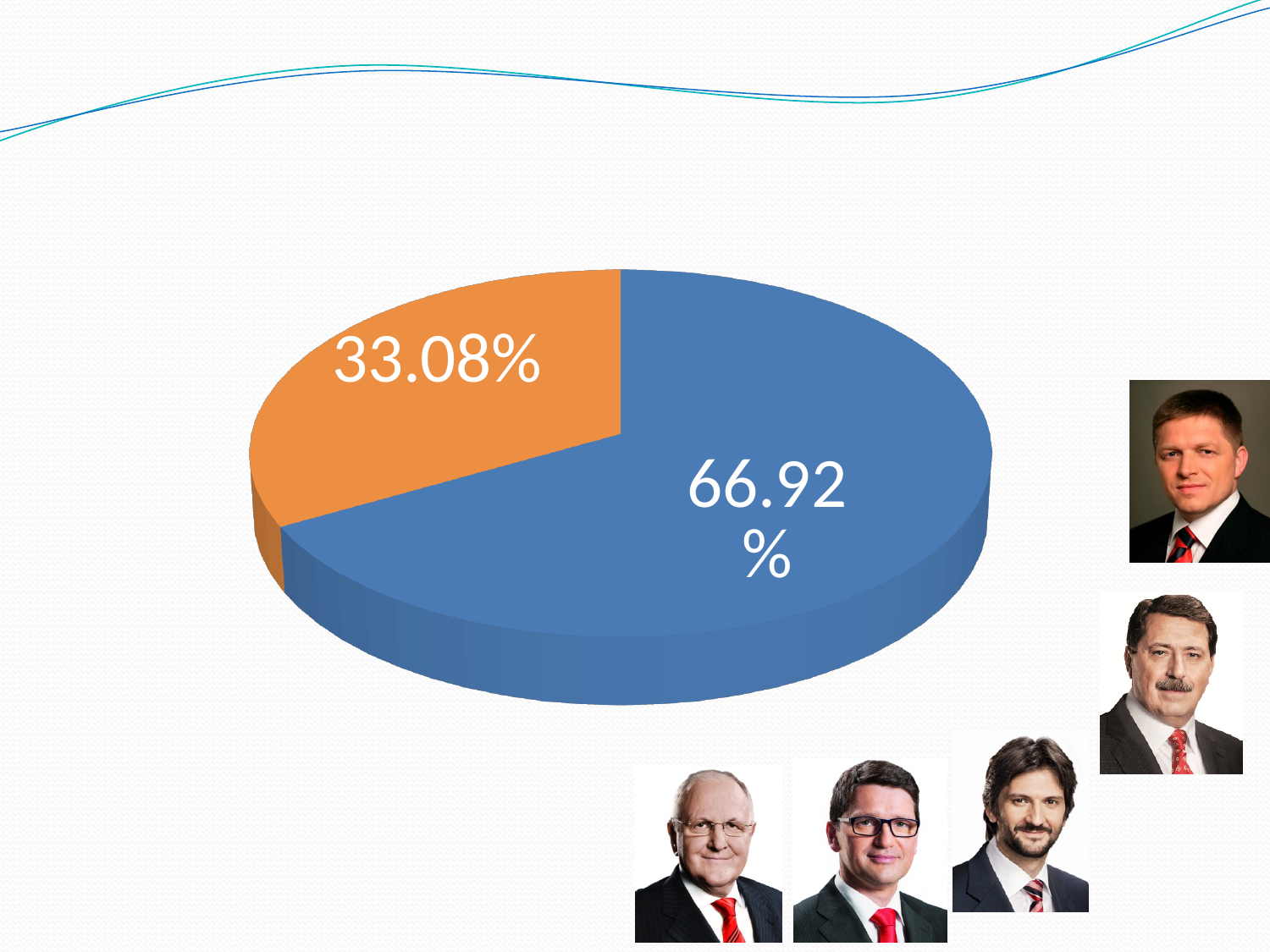
What percentage is shown on the blue slice of the pie chart? 66.92% What kind of chart is shown on the slide? pie chart What colours are the two slices of the pie chart? blue and orange Is the blue slice's share of the pie greater or less than 50%? greater What percentage is shown on the orange slice of the pie chart? 33.08% Which is larger, the blue slice or the orange slice? the blue slice Which slice of the pie chart is the smallest? the orange slice What is the difference between the blue slice's percentage and the orange slice's percentage? 33.84% Which slice of the pie chart is the largest? the blue slice What share of the pie does the orange slice represent? 33.08% Is the orange slice's share of the pie greater or less than 50%? less How many slices does the pie chart have? 2